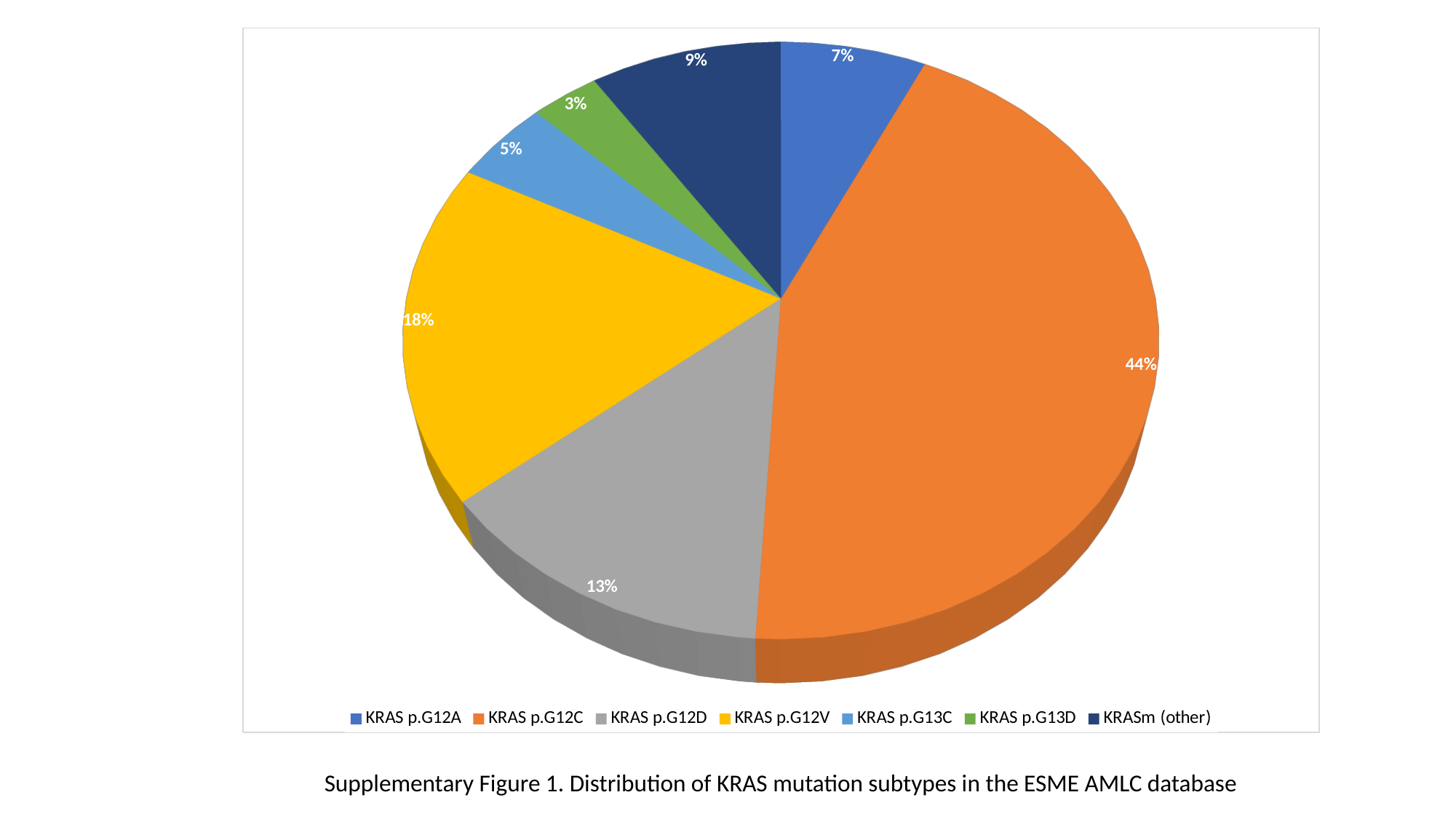
What kind of chart is shown on the slide? Pie chart What is the value shown for KRAS p.G12D? 13% What is the value shown for KRAS p.G12A? 7% What share of the pie does KRAS p.G12C represent? 44% What is the value shown for KRASm (other)? 9% How many slices does the pie chart have? 7 Which KRAS mutation subtype has the largest slice? KRAS p.G12C Which KRAS mutation subtype has the smallest slice? KRAS p.G13D What share of the pie does KRAS p.G12V represent? 18% What colour is the slice for KRAS p.G12V? Yellow Which is larger, the share for KRAS p.G13C or the share for KRAS p.G12A? KRAS p.G12A What is the difference in percentage points between KRAS p.G12C and KRAS p.G12V? 26